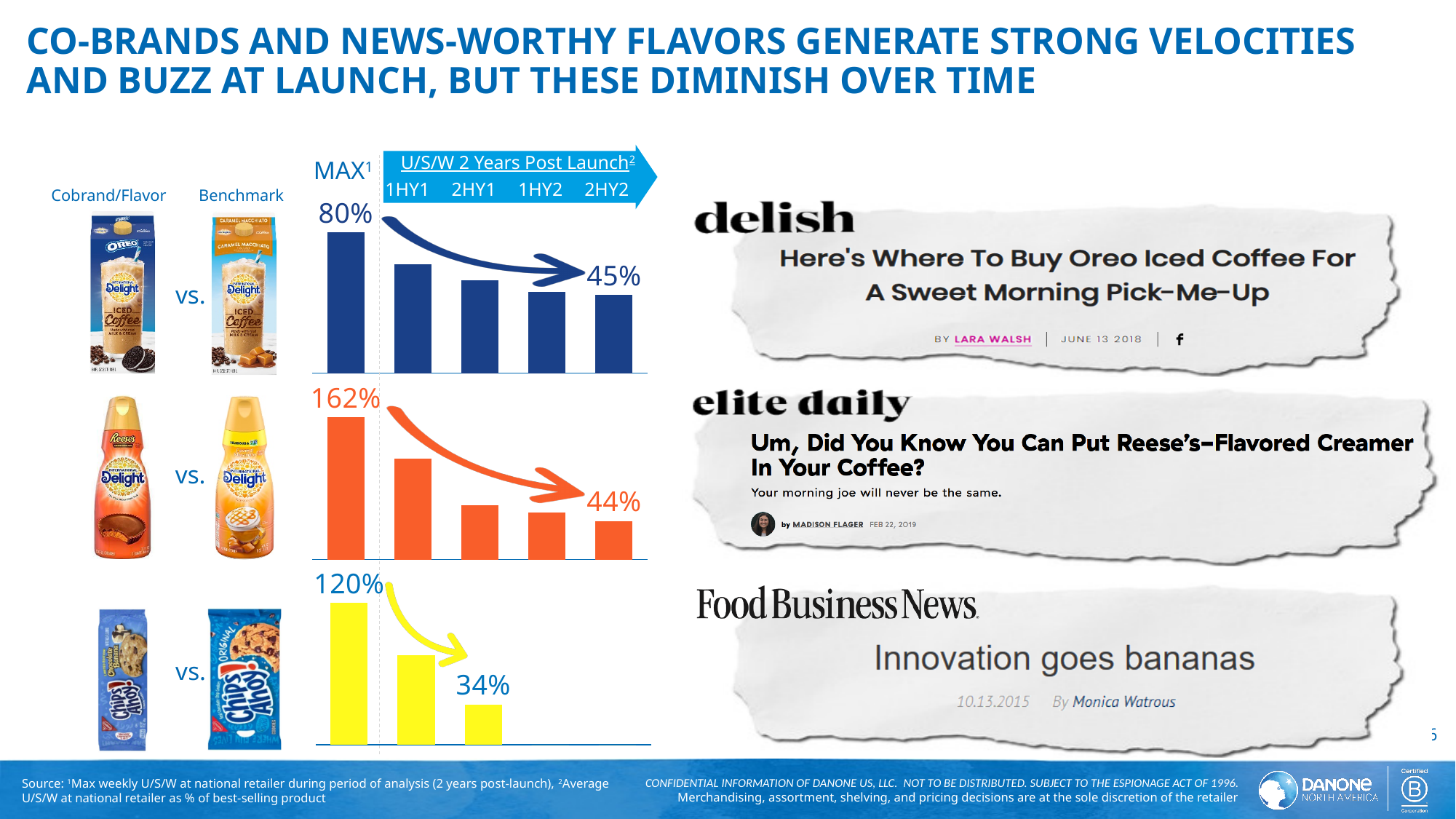
In the top (blue) chart for the Oreo Iced Coffee co-brand, what is the MAX value shown? 80% How many bars are plotted in the bottom (yellow) Chips Ahoy chart? 3 In the top (blue) chart, what is the difference between the MAX value and the 2HY2 value? 35 percentage points In the top (blue) chart, what value is labeled at the end of the arrow for 2HY2? 45% In the middle (orange) chart, what is the difference between the MAX value and the 2HY2 value? 118 percentage points In the top (blue) chart, do the values rise or fall from MAX through 2HY2? Fall In the middle (orange) chart for the Reese's creamer co-brand, what is the MAX value shown? 162% What type of chart is used to show the co-brand velocities on this slide? Bar chart In the bottom (yellow) chart, what value is labeled at the end of the arrow? 34% In the middle (orange) chart, what value is labeled at the end of the arrow for 2HY2? 44% Which of the three co-brand charts has the highest MAX value? The middle (orange) Reese's chart, 162% In the bottom (yellow) chart for the Chips Ahoy co-brand, what is the MAX value shown? 120%